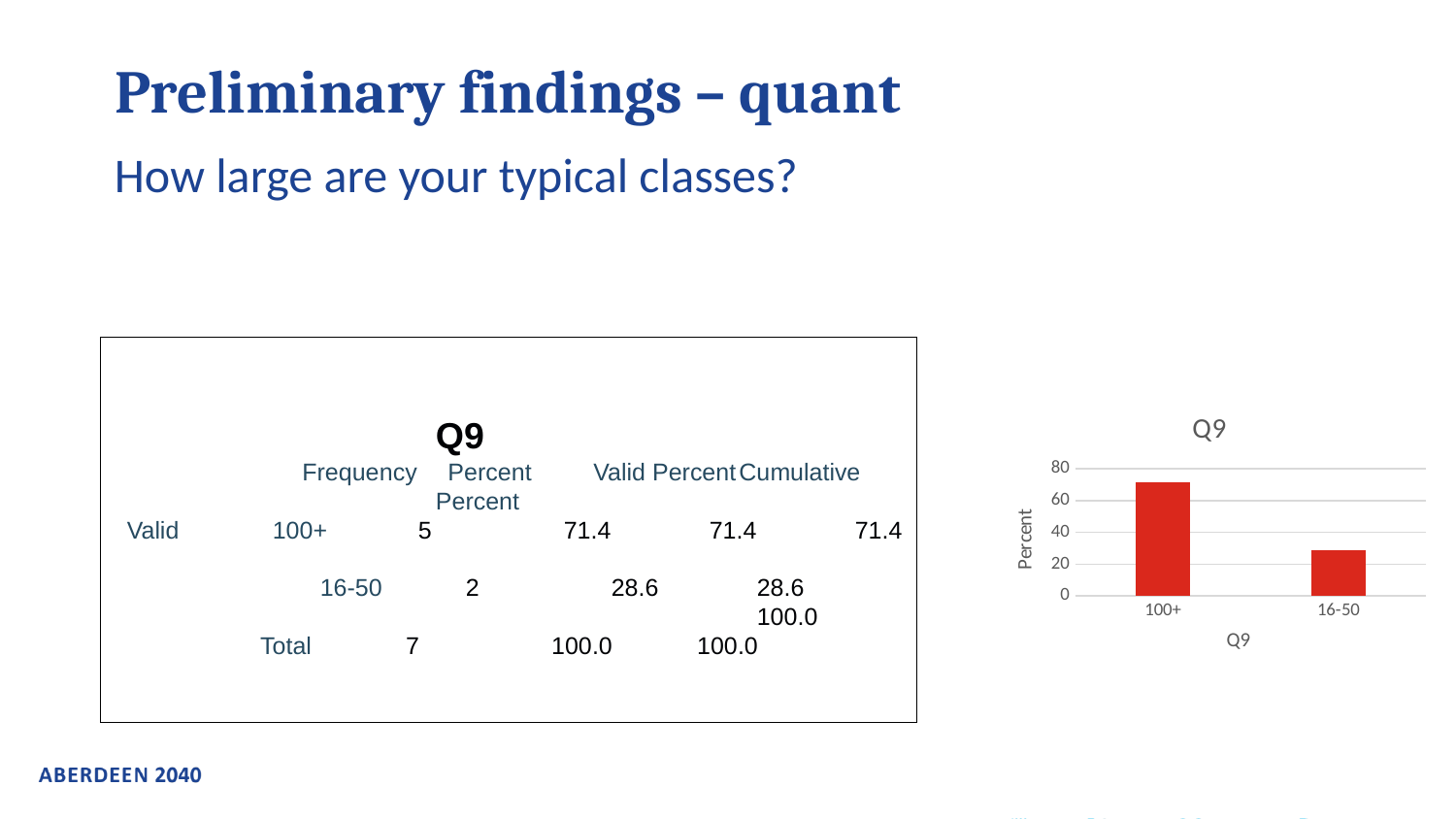
How many categories are shown on the x axis of the chart? 2 Which category has the lowest bar in the chart? 16-50 What is the title of the chart? Q9 What is the label of the y axis of the chart? Percent Do the bar values rise or fall from left to right along the x axis? fall What kind of chart is shown on the slide? bar chart Which category has the highest bar in the chart? 100+ Is the value for 100+ greater or less than 60? greater Is the value for 16-50 greater or less than 20? greater Is the value for 100+ greater or less than 80? less Which is larger, the bar for 100+ or the bar for 16-50? 100+